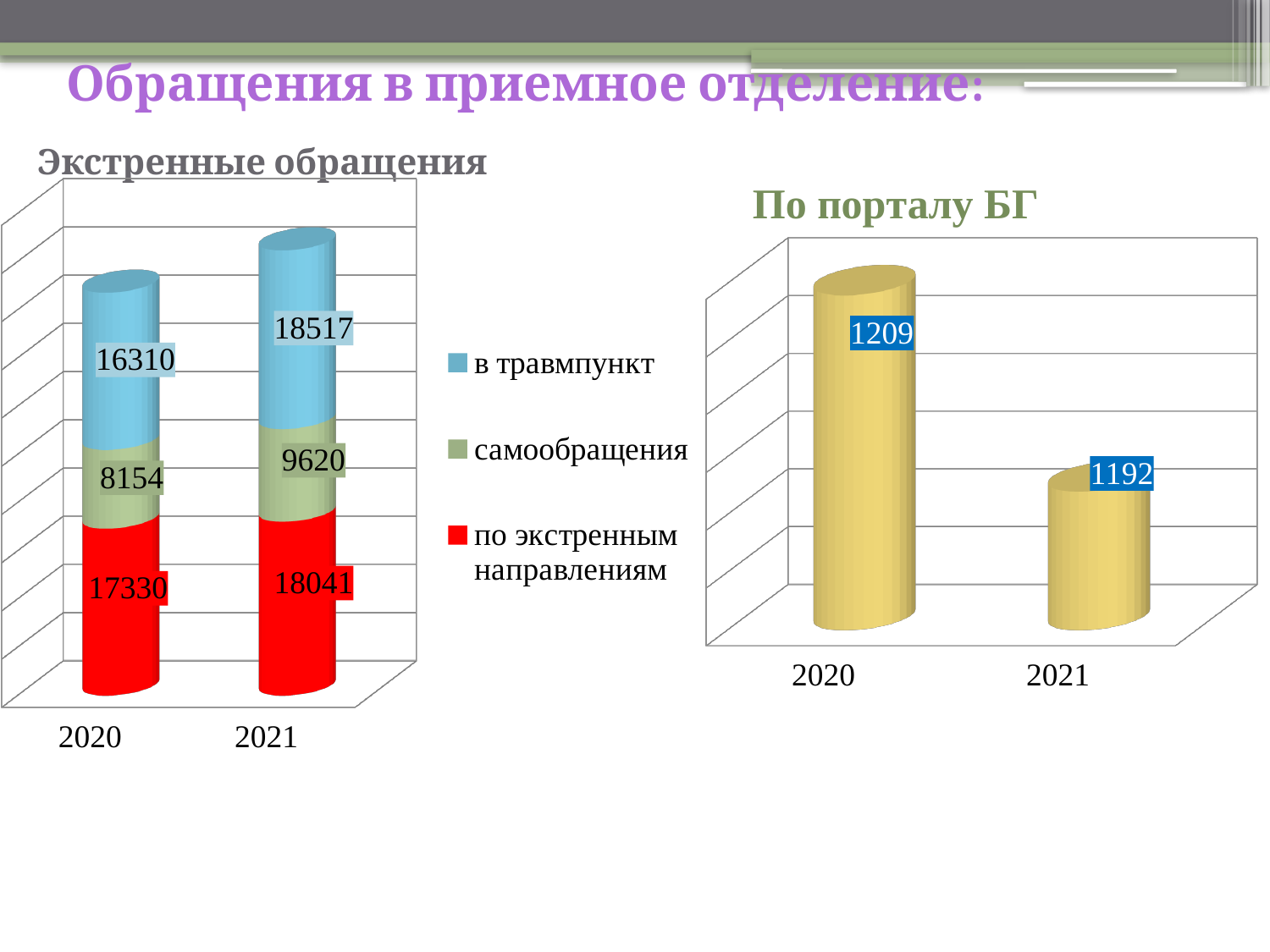
In the 'По порталу БГ' chart, what is the value for 2021? 1192 In the 'По порталу БГ' chart, which year has the higher value, 2020 or 2021? 2020 In the 'Экстренные обращения' chart, what is the value for 'в травмпункт' in 2021? 18517 In the 'По порталу БГ' chart, what is the difference between the 2020 and 2021 values? 17 In the 'Экстренные обращения' chart, what is the total of the stacked bar for 2021? 46178 How many series does the legend of the 'Экстренные обращения' chart list? 3 In the 'Экстренные обращения' chart, what is the value for 'самообращения' in 2020? 8154 In the 'Экстренные обращения' chart, what is the value for 'по экстренным направлениям' in 2021? 18041 In the 'Экстренные обращения' chart, by how much did 'в травмпункт' increase from 2020 to 2021? 2207 What kind of chart is the 'По порталу БГ' chart? bar chart In the 'По порталу БГ' chart, what is the value for 2020? 1209 In the 'Экстренные обращения' chart, what is the total of the stacked bar for 2020? 41794